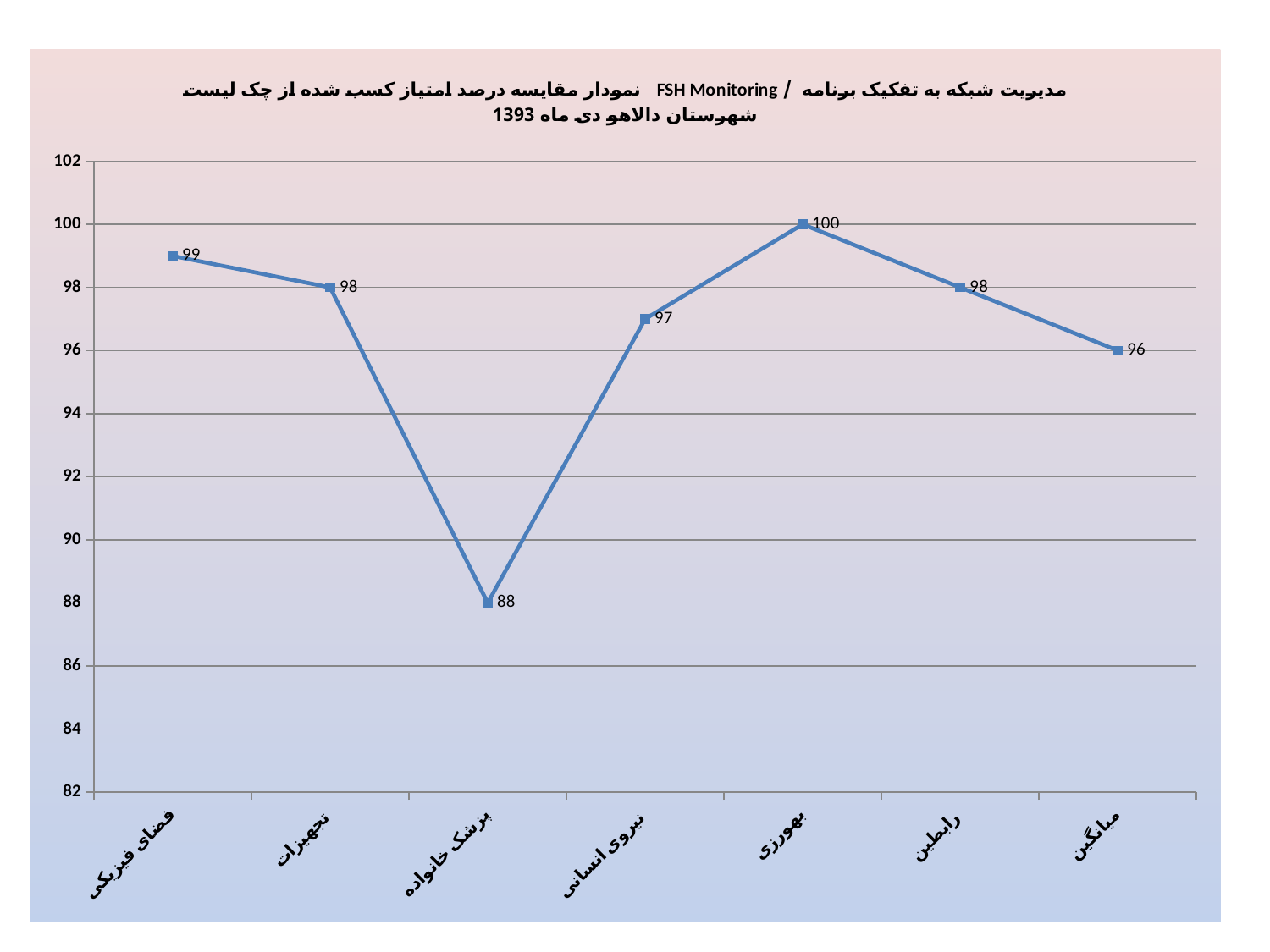
How many categories are plotted on the x axis? 7 Which category has the lowest value? پزشک خانواده What is the value for میانگین? 96 Is the value for پزشک خانواده greater or less than 90? less What is the value for بهورزی? 100 Which is larger, the value for نیروی انسانی or the value for رابطین? رابطین What is the value for پزشک خانواده? 88 What type of chart is shown on the slide? line chart What is the difference between the values for بهورزی and پزشک خانواده? 12 What is the value for فضای فیزیکی? 99 Which category has the highest value? بهورزی Does the value rise or fall from تجهیزات to پزشک خانواده? fall